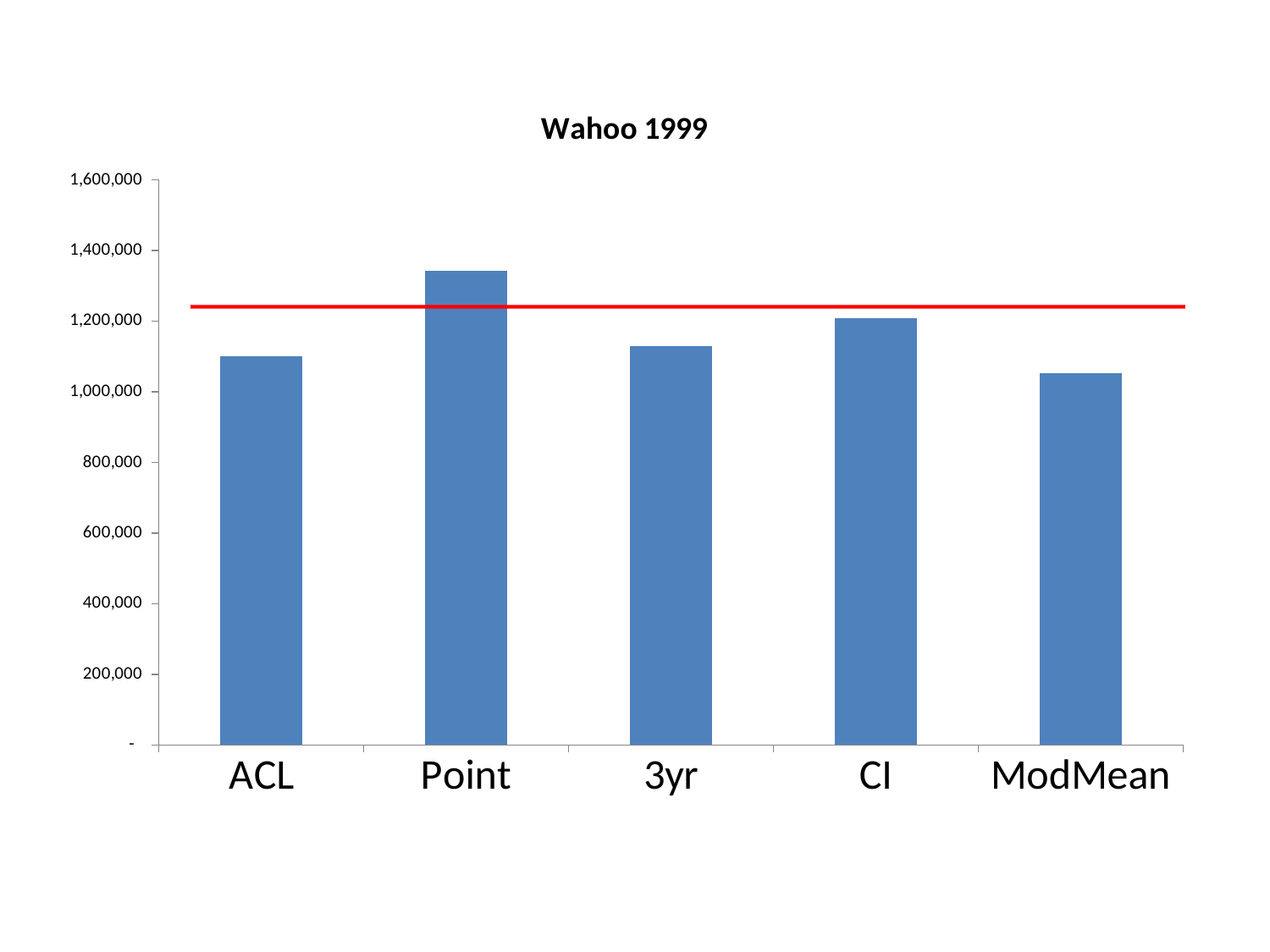
Is the value for CI greater or less than 1,400,000? less Is the value for Point greater or less than 1,200,000? greater Is the value for ACL greater or less than 1,000,000? greater What kind of chart is shown on the slide? bar chart Which category has the highest bar? Point Which is the only bar that rises above the red horizontal line? Point What is the title of the chart? Wahoo 1999 Which category has the lowest bar? ModMean How many categories are shown on the x axis? 5 Which is larger, the value for Point or the value for ACL? Point Which is larger, the value for CI or the value for ModMean? CI